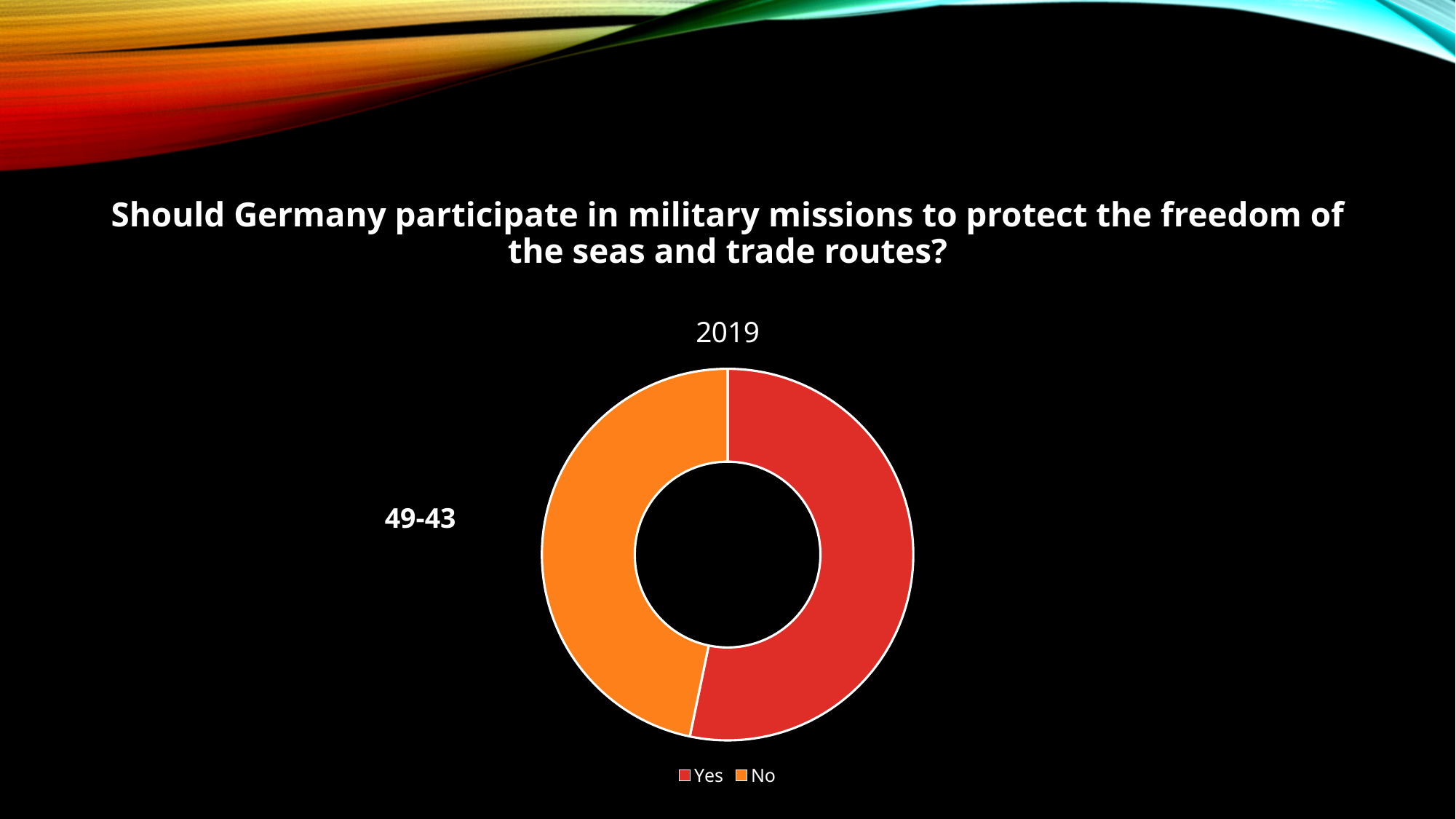
What colour represents the 'No' category in the chart? Orange How many slices does the doughnut chart have? 2 Which category has the largest slice in the chart? Yes What year is shown as the title of the doughnut chart? 2019 Which slice is larger in the chart, Yes or No? Yes Which category has the smallest slice in the chart? No How many categories does the legend of the chart list? 2 What kind of chart is shown on the slide? Doughnut (pie) chart